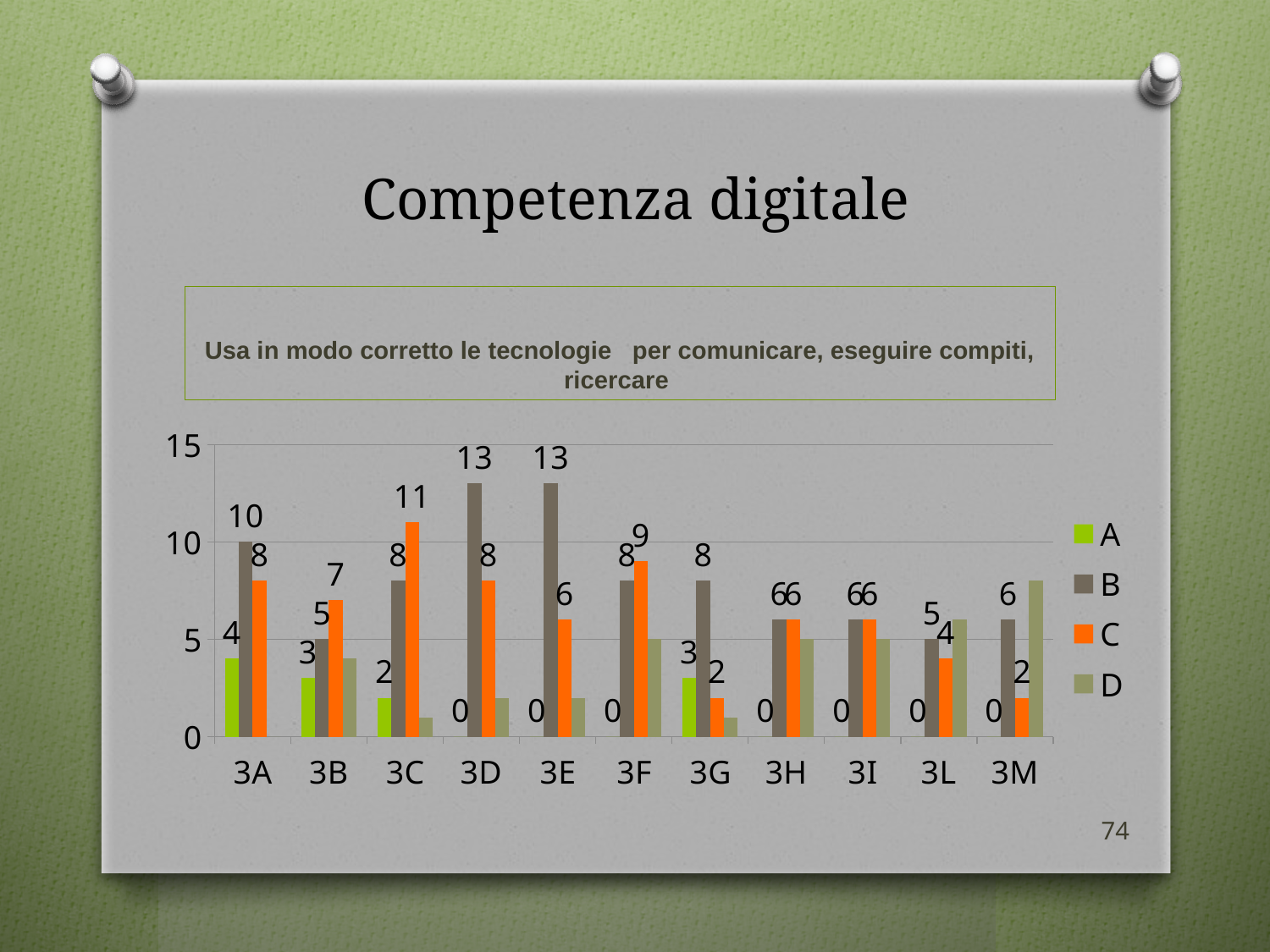
How many series does the legend list? 4 What is the difference between series B and series C for category 3A? 2 What is the value of series A for category 3A? 4 Is the value of series D for category 3M greater or less than 5? greater Which category has the highest value for series C? 3C What is the value of series B for category 3D? 13 What is the value of series C for category 3C? 11 How many categories are shown on the x axis? 11 What is the value of series A for category 3G? 3 What is the title of the slide containing the chart? Competenza digitale What kind of chart is shown on the slide? bar chart For category 3F, which is larger: series B or series C? C